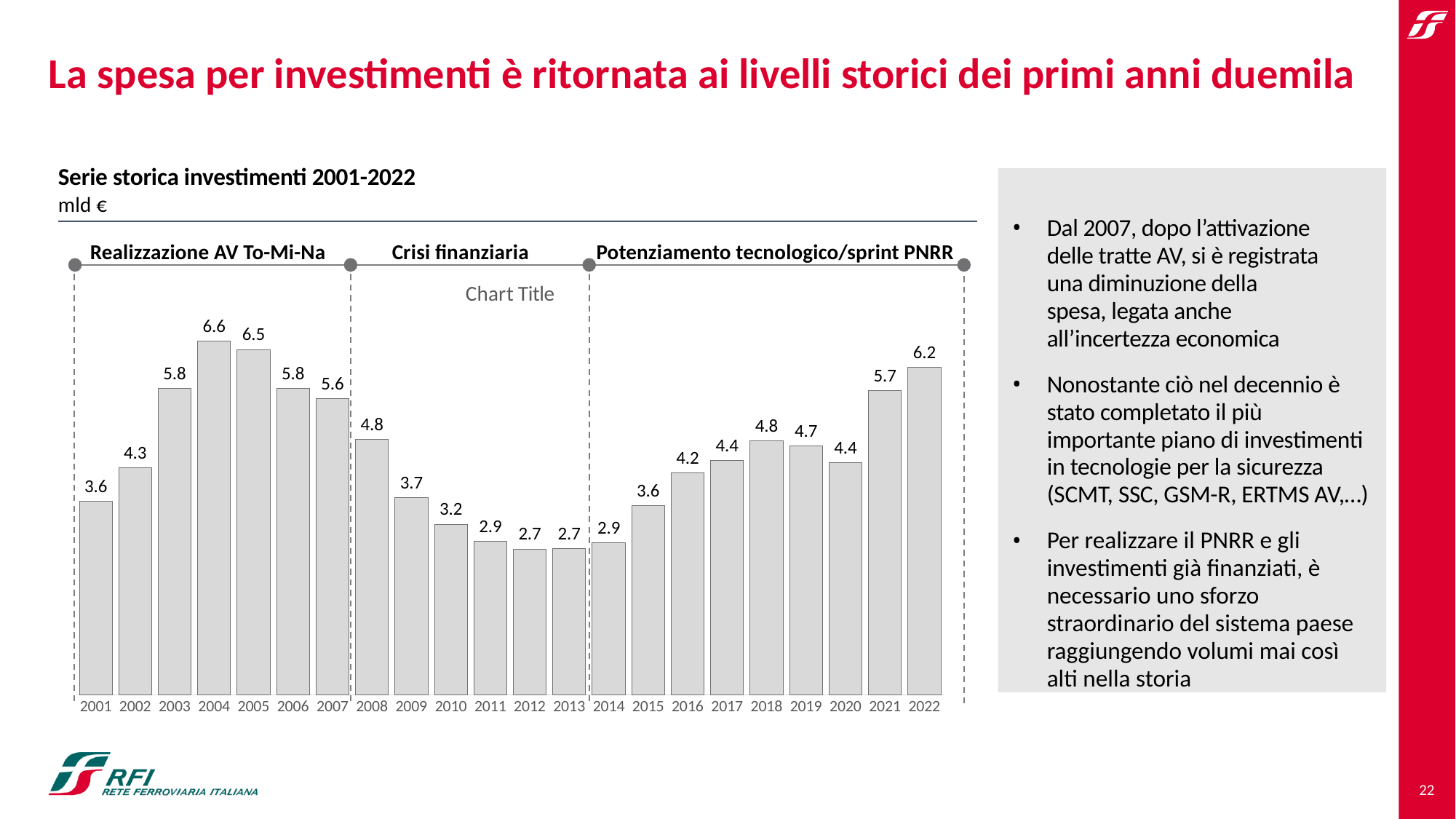
What is the difference between the investment values for 2004 and 2001? 3.0 What kind of chart is shown on the slide? Bar chart Which year has the larger investment value, 2008 or 2021? 2021 What is the difference between the investment values for 2022 and 2013? 3.5 How many years are plotted in the chart? 22 What unit is given for the values in the chart? mld € Which year has the highest investment value? 2004 Do the investment values rise or fall from 2008 to 2012? Fall What is the investment value shown for 2004? 6.6 What is the investment value shown for 2022? 6.2 What is the investment value shown for 2012? 2.7 What is the lowest investment value shown in the chart? 2.7